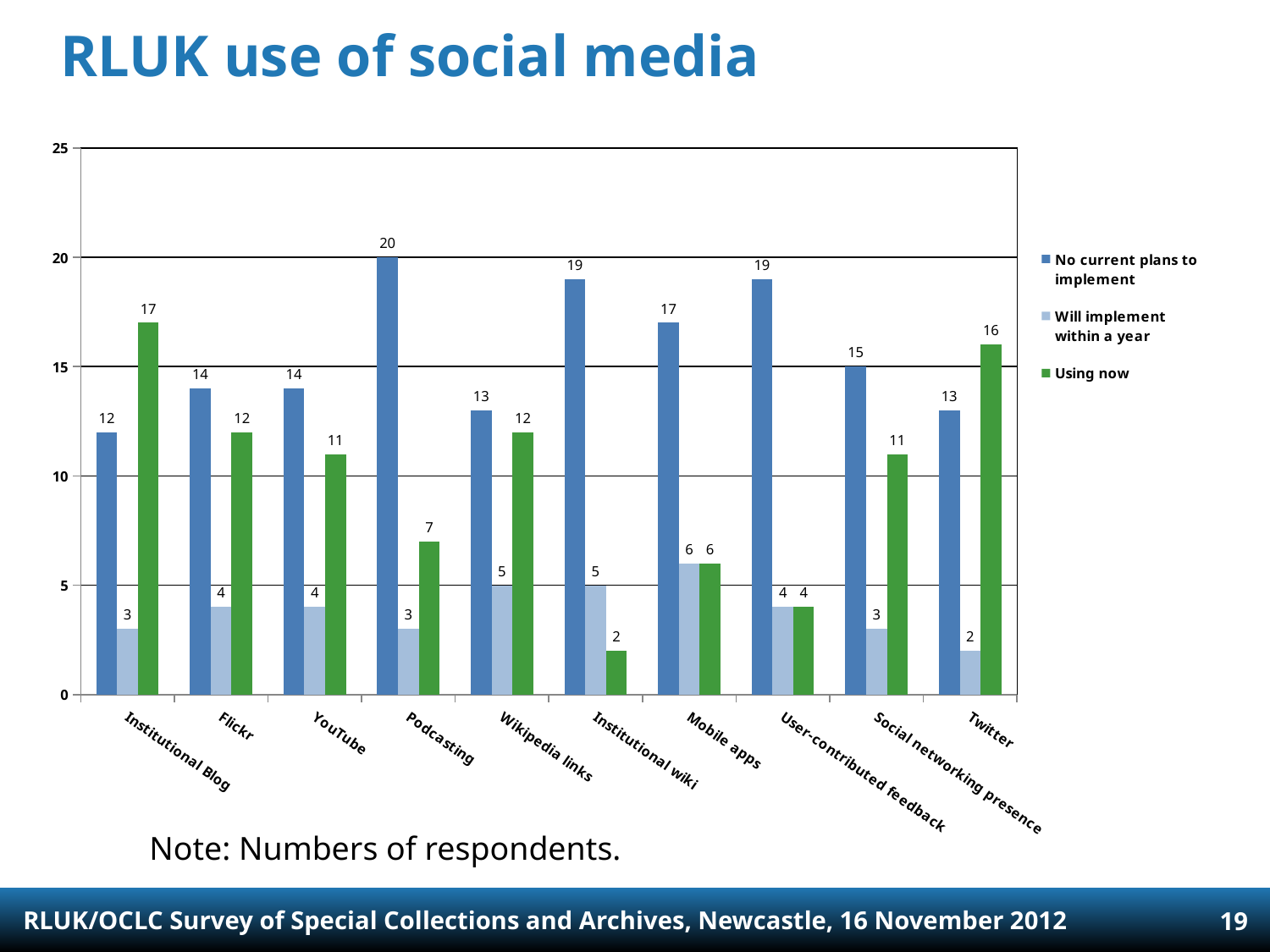
Which category has the highest 'No current plans to implement' value? Podcasting Which category has the highest 'Using now' value? Institutional Blog What is the title of the chart on the slide? RLUK use of social media How many series does the legend list? 3 How many social media categories are shown on the x axis? 10 How many respondents said they 'Will implement within a year' for Mobile apps? 6 Which category has the lowest 'Using now' value? Institutional wiki What is the difference between the 'No current plans to implement' and 'Using now' values for Institutional wiki? 17 How many respondents reported 'No current plans to implement' for Podcasting? 20 What type of chart is shown on the slide? Bar chart What is the 'Using now' value for Twitter? 16 Which is larger for Flickr: 'No current plans to implement' or 'Using now'? No current plans to implement